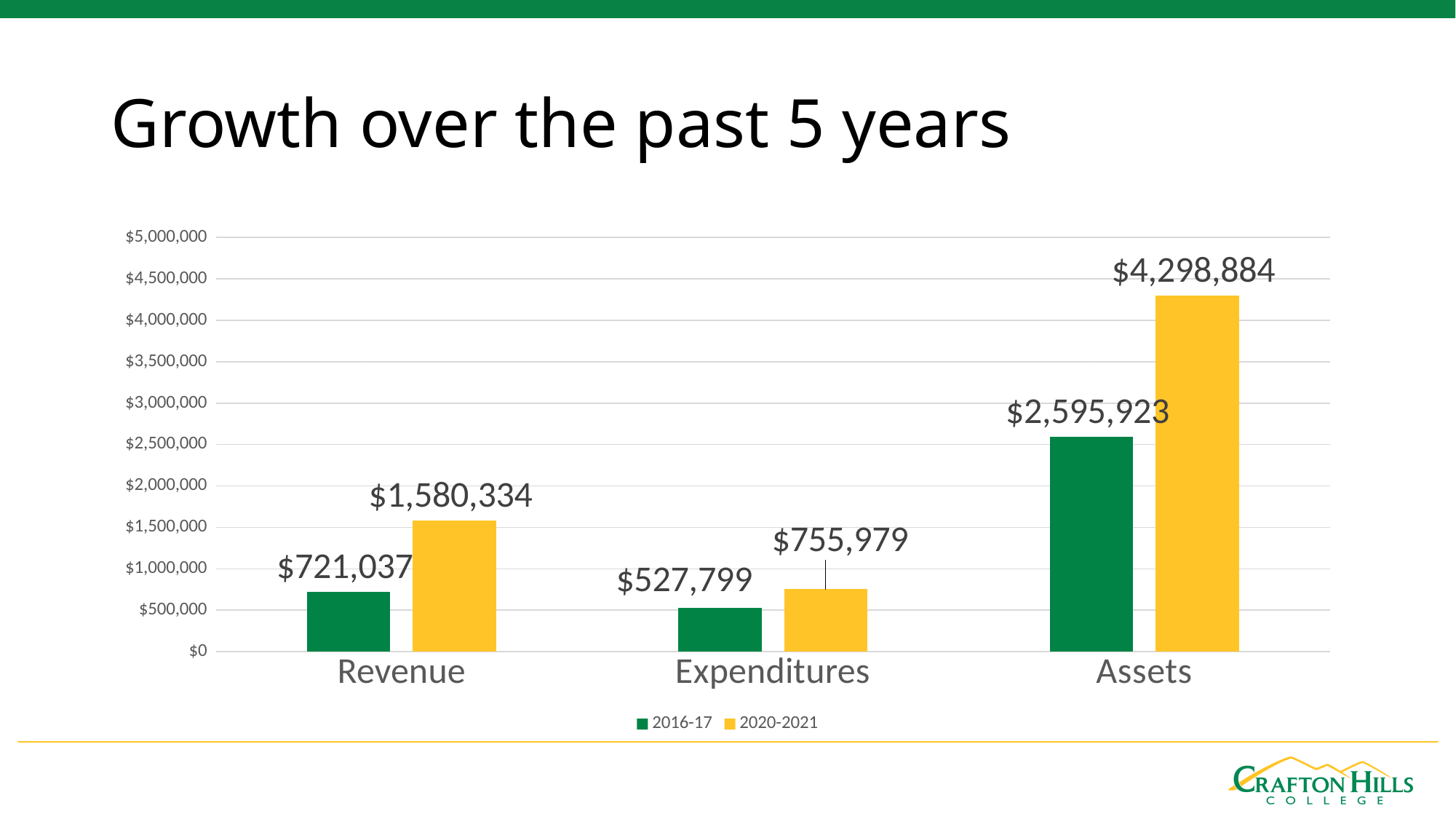
How many categories are shown on the x axis? 3 Which is larger: the 2020-2021 value for Revenue or the 2020-2021 value for Expenditures? Revenue What is the 2016-17 value for Revenue? $721,037 What is the 2020-2021 value for Assets? $4,298,884 Which category has the lowest 2016-17 value? Expenditures What is the difference between the 2020-2021 and 2016-17 values for Assets? $1,702,961 Which category has the highest 2020-2021 value? Assets What type of chart is shown on the slide? Bar chart What is the 2016-17 value for Assets? $2,595,923 How many series does the legend list? 2 What is the 2020-2021 value for Expenditures? $755,979 What is the difference between the 2020-2021 and 2016-17 values for Revenue? $859,297